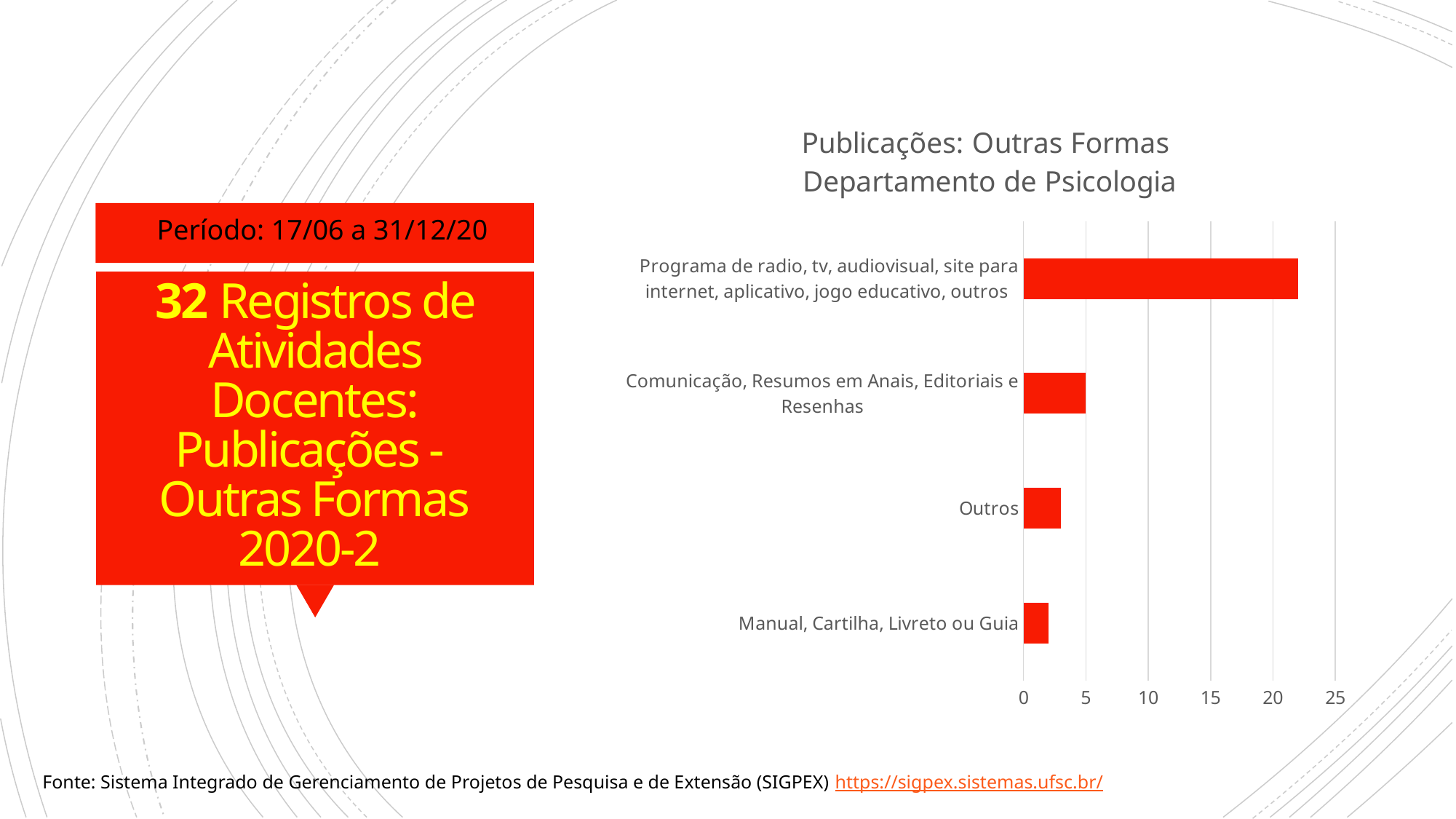
Which category has the highest value in the chart? Programa de radio, tv, audiovisual, site para internet, aplicativo, jogo educativo, outros What kind of chart is shown on the slide? bar chart Which is larger: the value for "Comunicação, Resumos em Anais, Editoriais e Resenhas" or the value for "Outros"? Comunicação, Resumos em Anais, Editoriais e Resenhas What is the title of the chart? Publicações: Outras Formas Departamento de Psicologia Which category has the lowest value in the chart? Manual, Cartilha, Livreto ou Guia Is the value for "Outros" greater or less than 5? less Is the value for "Comunicação, Resumos em Anais, Editoriais e Resenhas" greater or less than 10? less How many categories are plotted in the chart? 4 Is the value for "Programa de radio, tv, audiovisual, site para internet, aplicativo, jogo educativo, outros" greater or less than 20? greater Which is larger: the value for "Outros" or the value for "Manual, Cartilha, Livreto ou Guia"? Outros What is the highest tick value shown on the chart's value axis? 25